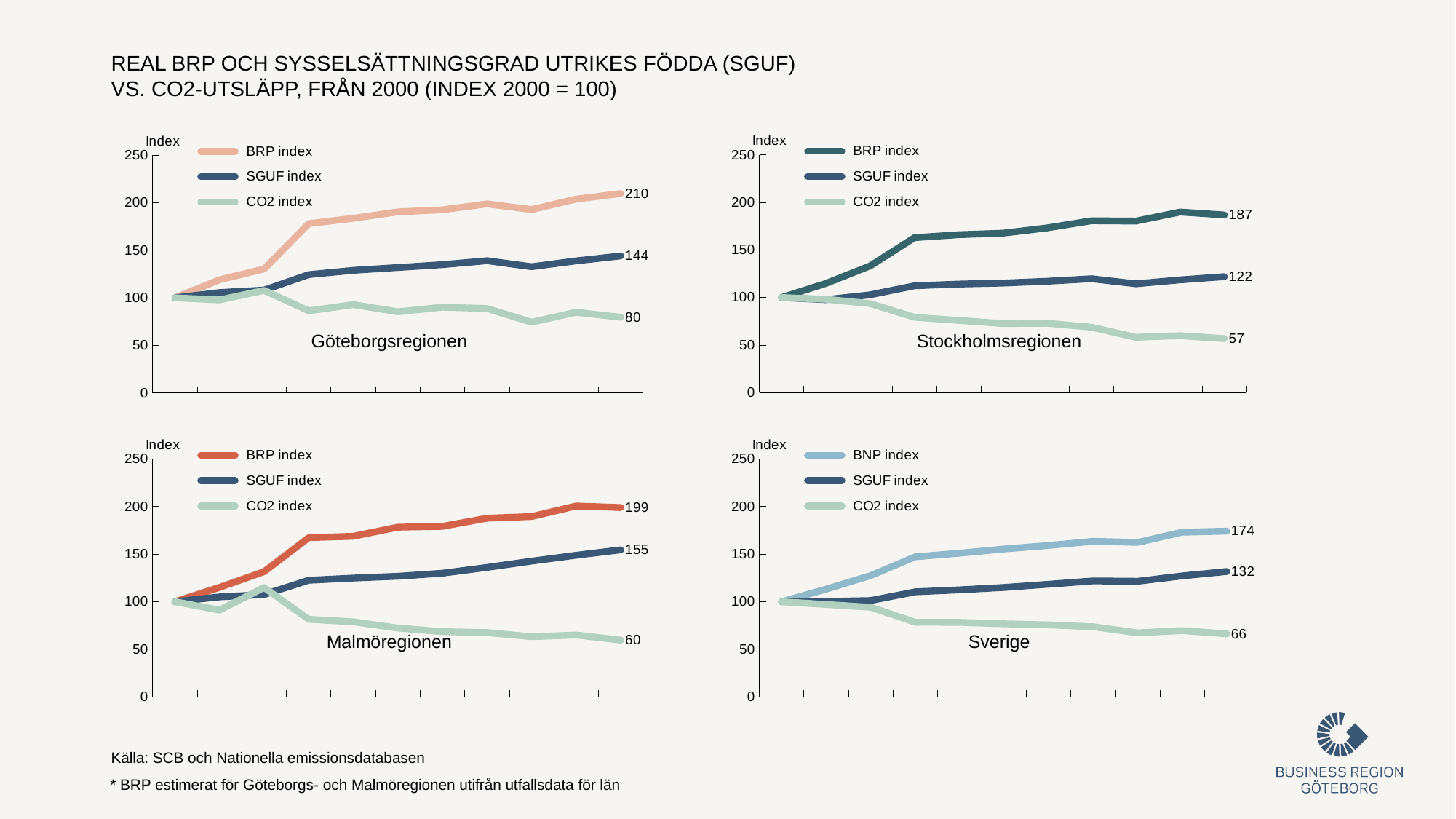
In the Malmöregionen chart, what is the final value of the SGUF index? 155 What type of chart is used for Stockholmsregionen? line chart In the Sverige chart, does the CO2 index rise or fall over the period? fall In the Stockholmsregionen chart, what is the final value of the CO2 index? 57 In the Göteborgsregionen chart, what is the difference between the final BRP index and the final SGUF index? 66 How many series does the legend of the Malmöregionen chart list? 3 In the Malmöregionen chart, which series ends lowest? CO2 index In the Sverige chart, what is the difference between the final SGUF index and the final CO2 index? 66 In the Göteborgsregionen chart, what is the final value of the BRP index? 210 In the Stockholmsregionen chart, which series ends highest? BRP index Which is larger: the final BRP index in Göteborgsregionen or the final BRP index in Stockholmsregionen? Göteborgsregionen In the Sverige chart, what is the final value of the BNP index? 174